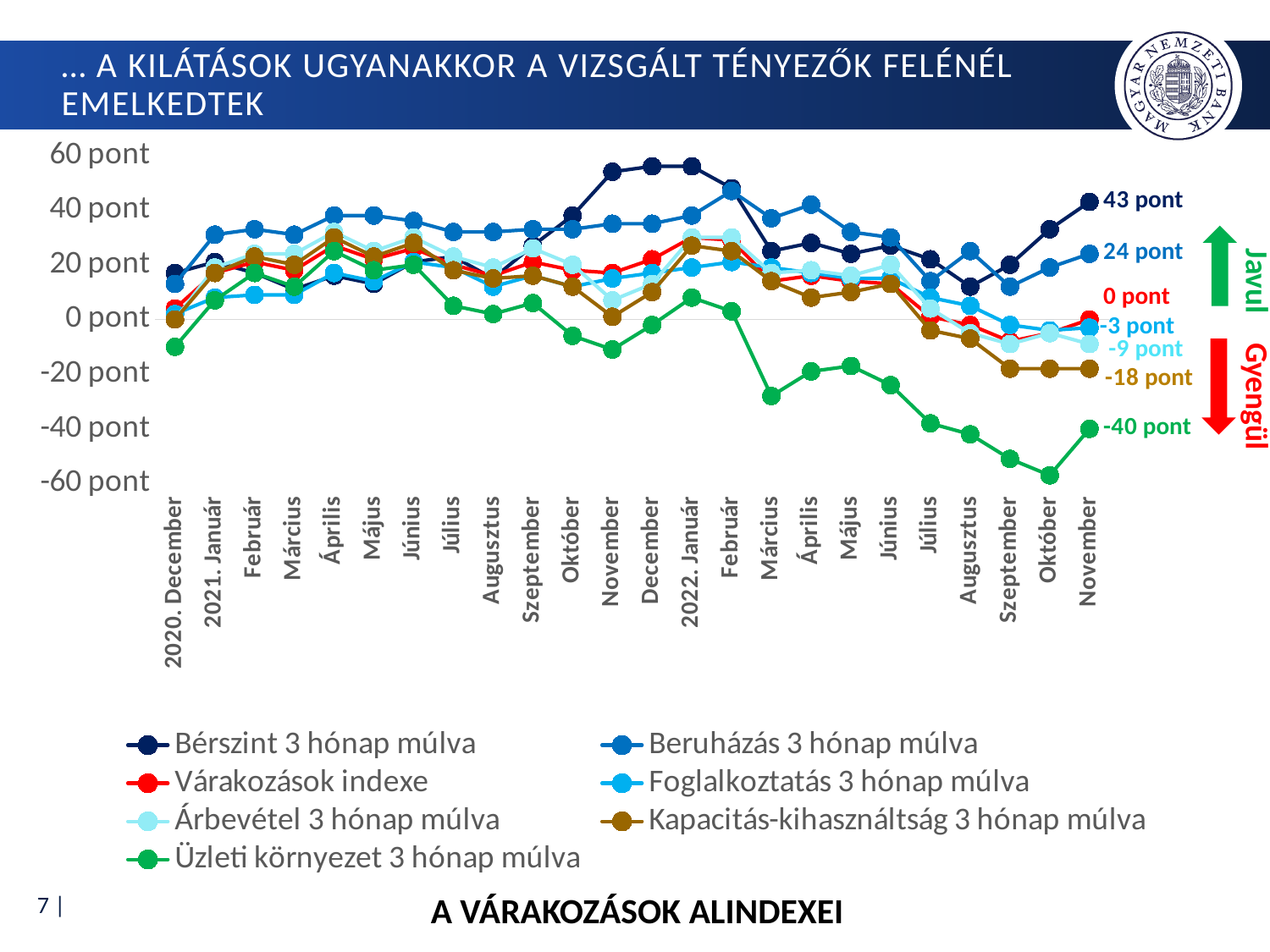
Is the value for Bérszint 3 hónap múlva in 2021 December greater or less than 40 pont? greater At the last point, which is larger: Foglalkoztatás 3 hónap múlva or Árbevétel 3 hónap múlva? Foglalkoztatás 3 hónap múlva Which series has the lowest value at the last point (2022 November)? Üzleti környezet 3 hónap múlva What kind of chart is shown on the slide? Line chart What is the value of Kapacitás-kihasználtság 3 hónap múlva at the last point (2022 November)? -18 pont What is the difference between the final values of Bérszint 3 hónap múlva (43 pont) and Beruházás 3 hónap múlva (24 pont)? 19 pont Which series has the highest value at the last point (2022 November)? Bérszint 3 hónap múlva What is the value of Bérszint 3 hónap múlva at the last point (2022 November)? 43 pont What is the value of Üzleti környezet 3 hónap múlva at the last point (2022 November)? -40 pont Does Üzleti környezet 3 hónap múlva rise or fall from 2022 Február to 2022 Október? Fall How many months (points) are shown on the x axis? 24 How many series does the legend list? 7